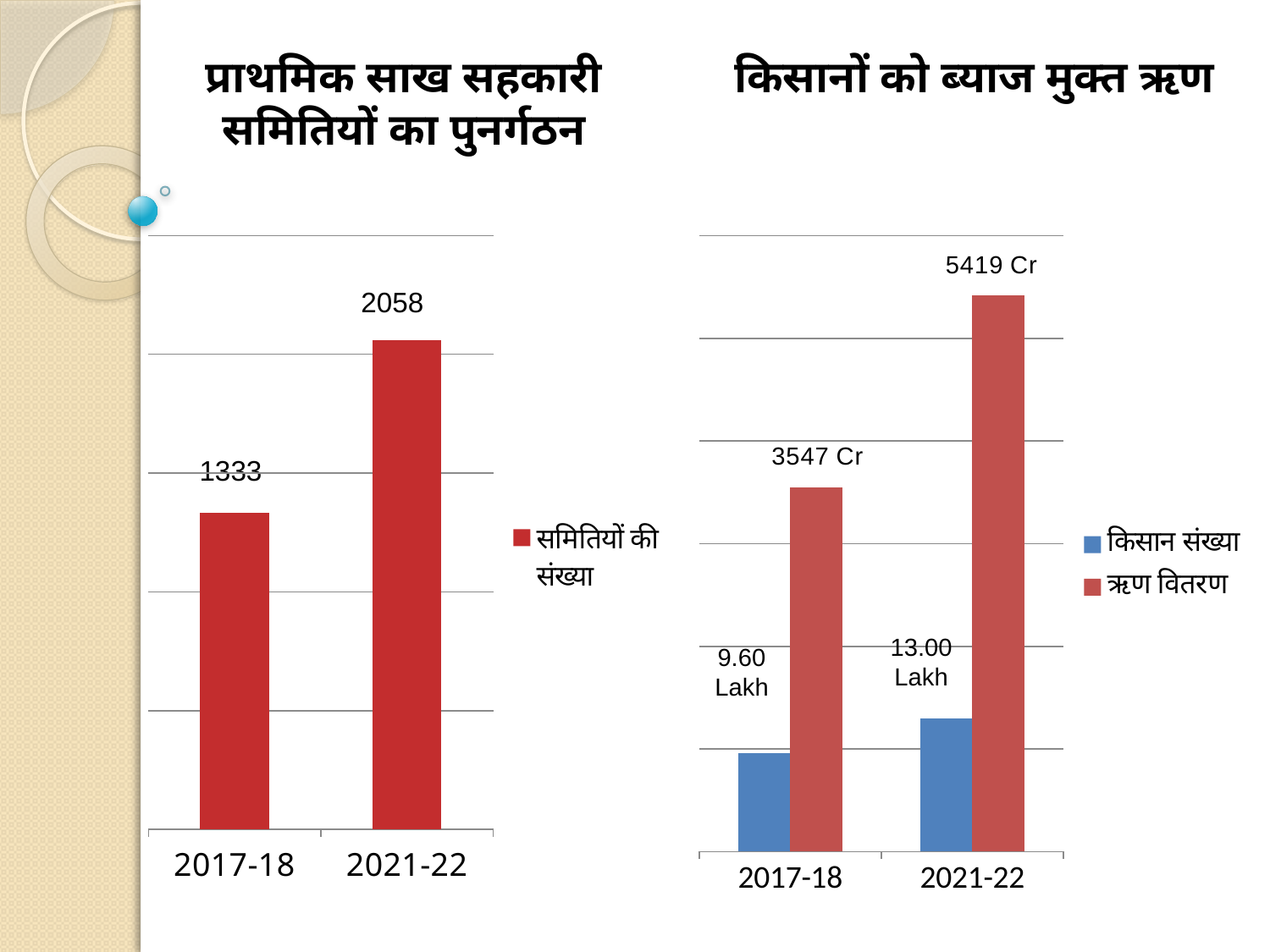
In the left chart (प्राथमिक साख सहकारी समितियों का पुनर्गठन), by how much did the value increase from 2017-18 to 2021-22? 725 In the left chart (प्राथमिक साख सहकारी समितियों का पुनर्गठन), how many series does the legend list? 1 In the right chart (किसानों को ब्याज मुक्त ऋण), what is the किसान संख्या value for 2017-18? 9.60 Lakh In the right chart (किसानों को ब्याज मुक्त ऋण), how many series does the legend list? 2 In the right chart (किसानों को ब्याज मुक्त ऋण), what is the ऋण वितरण value for 2021-22? 5419 Cr What type of chart is the right chart (किसानों को ब्याज मुक्त ऋण)? Bar chart In the left chart (प्राथमिक साख सहकारी समितियों का पुनर्गठन), what is the value for 2017-18? 1333 In the left chart (प्राथमिक साख सहकारी समितियों का पुनर्गठन), what is the value for 2021-22? 2058 In the right chart (किसानों को ब्याज मुक्त ऋण), what is the ऋण वितरण value for 2017-18? 3547 Cr In the left chart (प्राथमिक साख सहकारी समितियों का पुनर्गठन), which year has the higher value? 2021-22 In the right chart (किसानों को ब्याज मुक्त ऋण), what is the किसान संख्या value for 2021-22? 13.00 Lakh In the right chart (किसानों को ब्याज मुक्त ऋण), by how much did ऋण वितरण increase from 2017-18 to 2021-22? 1872 Cr